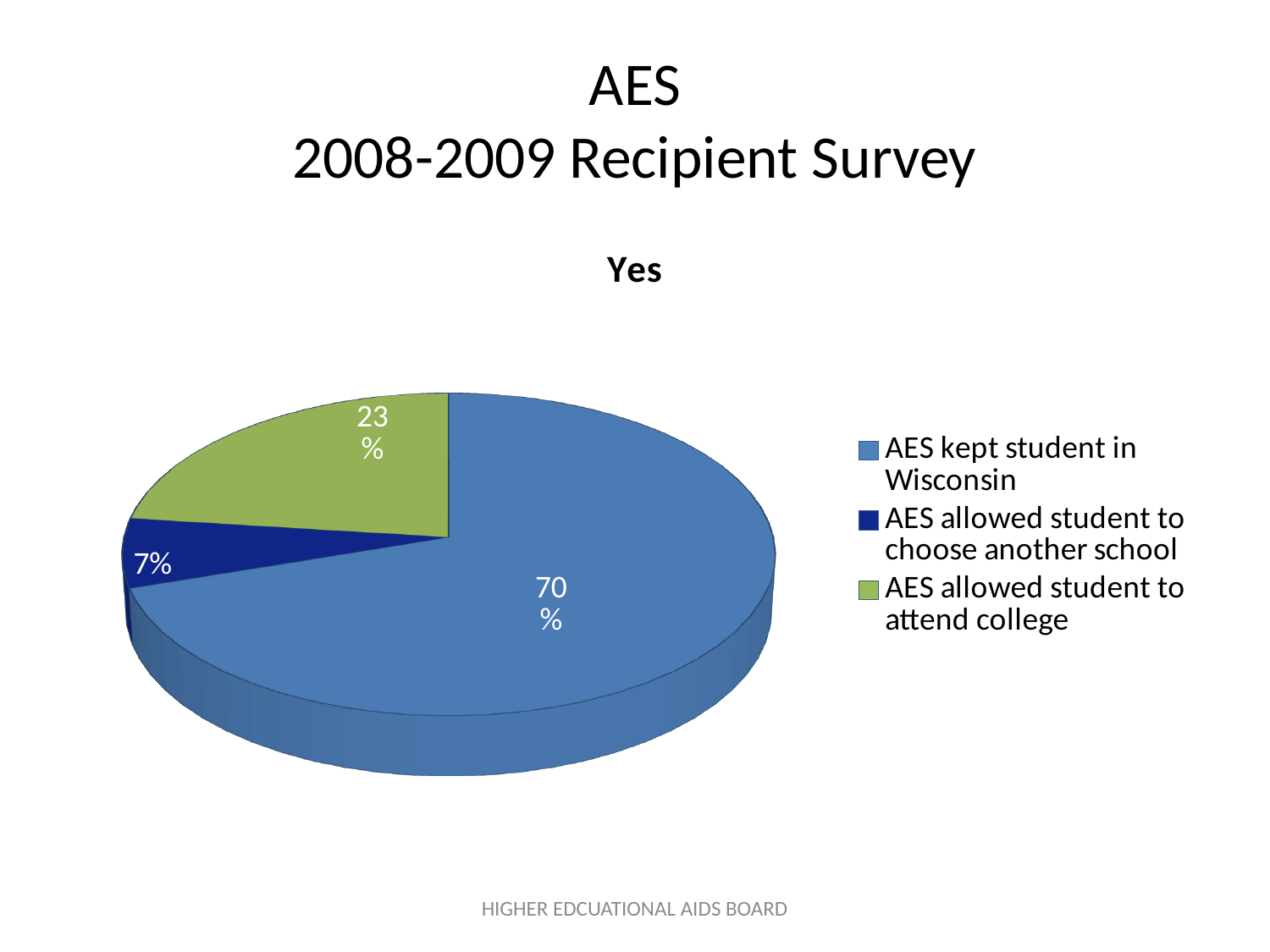
What kind of chart is shown on the slide? Pie chart Which category has the smallest slice of the pie? AES allowed student to choose another school How many slices does the pie chart have? 3 Which category has the largest slice of the pie? AES kept student in Wisconsin What share of the pie is labelled for 'AES allowed student to choose another school'? 7% What is the chart's title? Yes What is the difference in percentage points between 'AES kept student in Wisconsin' and 'AES allowed student to attend college'? 47 What share of the pie is labelled for 'AES allowed student to attend college'? 23% What share of the pie is labelled for 'AES kept student in Wisconsin'? 70% How many entries does the legend list? 3 What colour is the slice for 'AES allowed student to attend college'? Green Which is larger: the slice for 'AES allowed student to attend college' or the slice for 'AES allowed student to choose another school'? AES allowed student to attend college